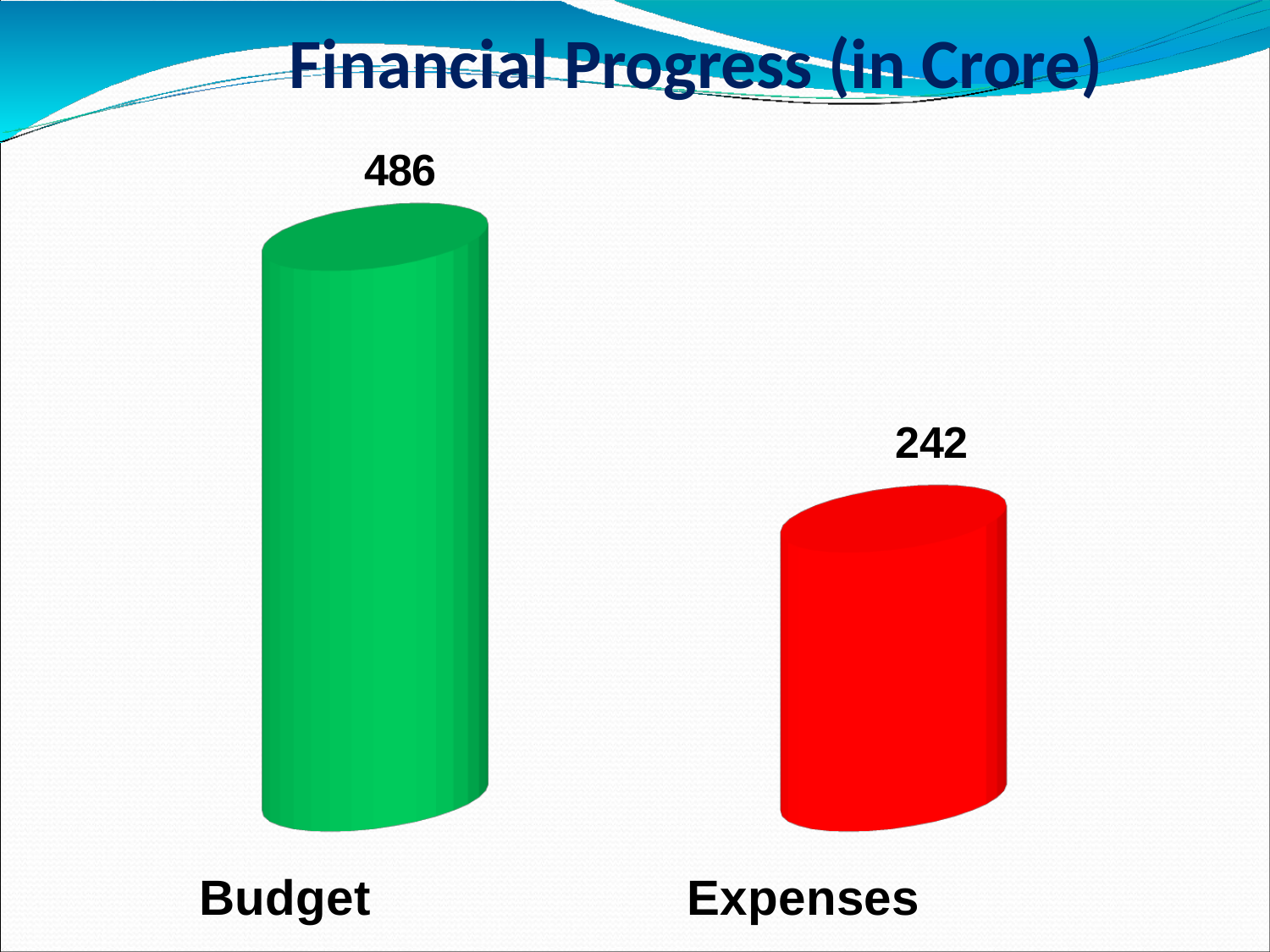
What is the value for Expenses? 242 Which category has the highest value? Budget What kind of chart is shown on the slide? Bar chart Which category has the lowest value? Expenses Which is larger, Budget or Expenses? Budget What colour is the Expenses bar? Red What is the value for Budget? 486 What is the difference between the Budget and Expenses values? 244 What is the title of the chart? Financial Progress (in Crore) How many categories are shown in the chart? 2